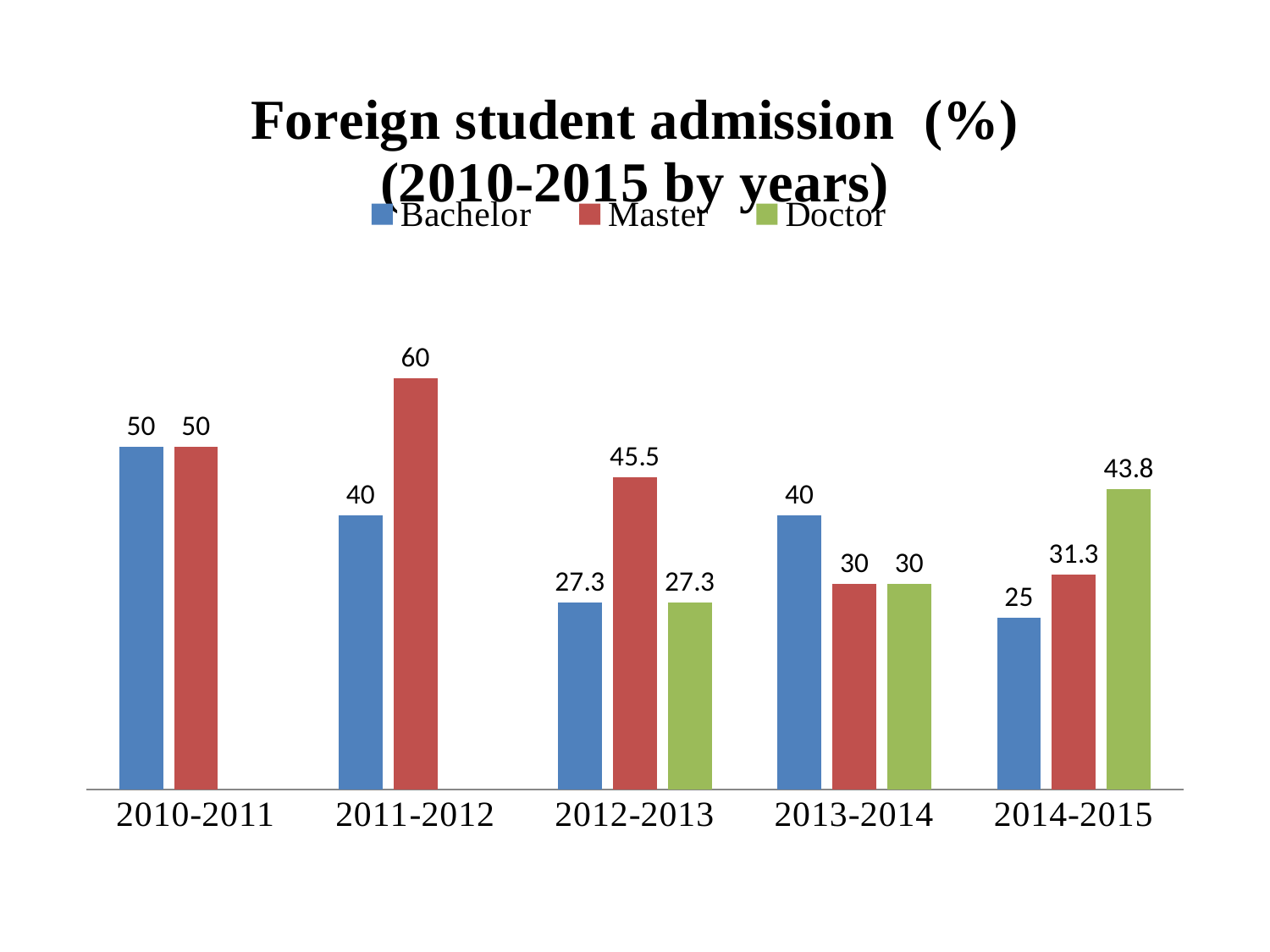
What is the difference between the Master and Bachelor values in 2011-2012? 20 What is the Doctor value for 2014-2015? 43.8 How many series does the legend list? 3 Which year has the lowest Bachelor value? 2014-2015 How many year categories are shown on the x axis? 5 Does the Bachelor value rise or fall from 2013-2014 to 2014-2015? Fall What is the Bachelor value for 2012-2013? 27.3 What is the difference between the Doctor and Master values in 2014-2015? 12.5 Which year has the highest Master value? 2011-2012 What kind of chart is shown on the slide? Bar chart In 2013-2014, which is larger, the Bachelor value or the Master value? Bachelor What is the Master value for 2011-2012? 60